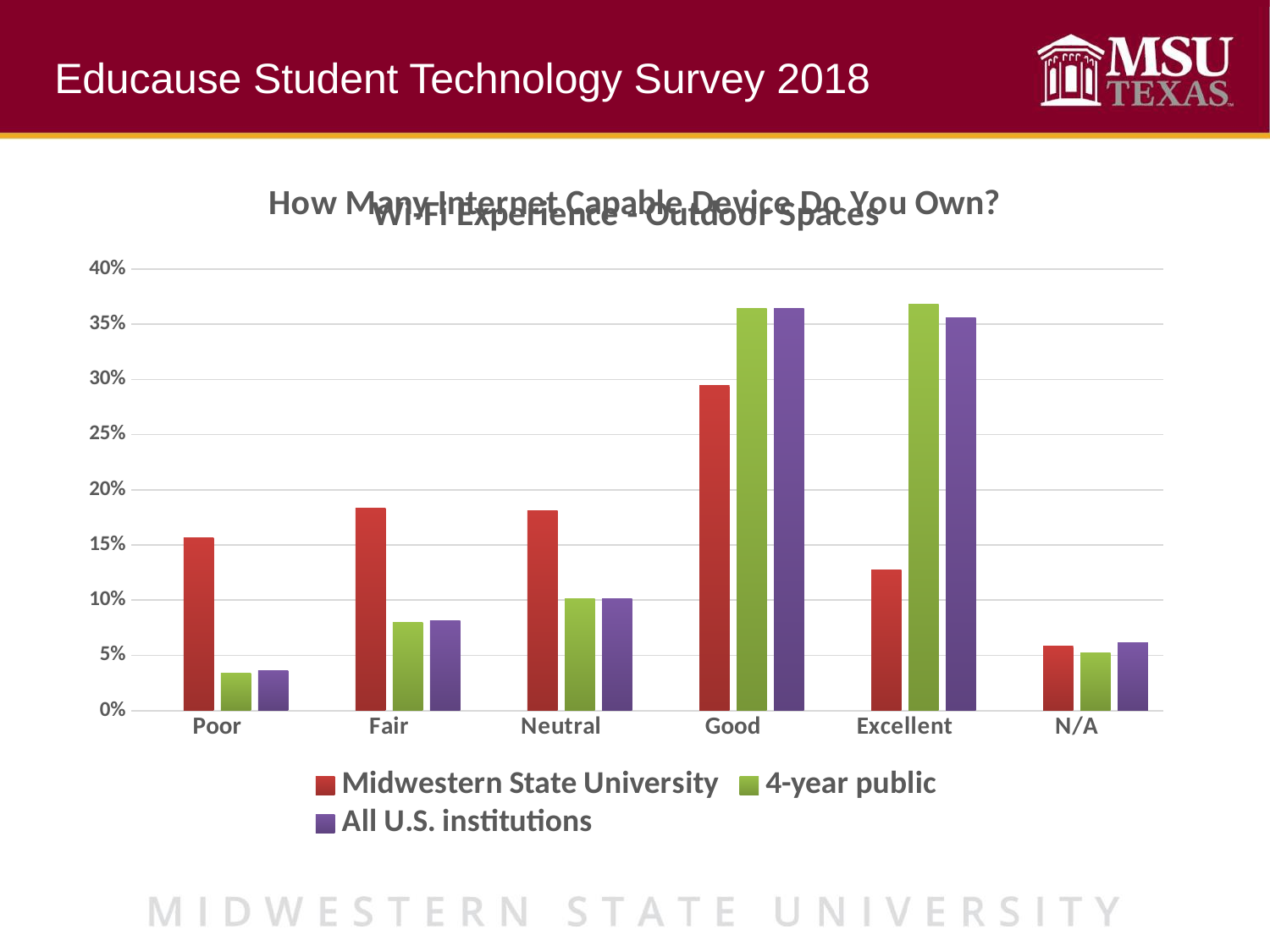
Is the value for Midwestern State University in the Good category greater or less than 25%? greater What kind of chart is shown on the slide? bar chart Which category has the highest value for Midwestern State University? Good Which category has the lowest value for Midwestern State University? N/A How many series does the chart's legend list? 3 How many categories are shown on the x axis of the chart? 6 Which category has the lowest value for 4-year public? Poor In the Excellent category, which is larger: Midwestern State University or All U.S. institutions? All U.S. institutions Is the value for All U.S. institutions in the Neutral category greater or less than 15%? less Which colour represents Midwestern State University in the legend? red Which category has the lowest value for All U.S. institutions? Poor In the Poor category, which is larger: Midwestern State University or 4-year public? Midwestern State University